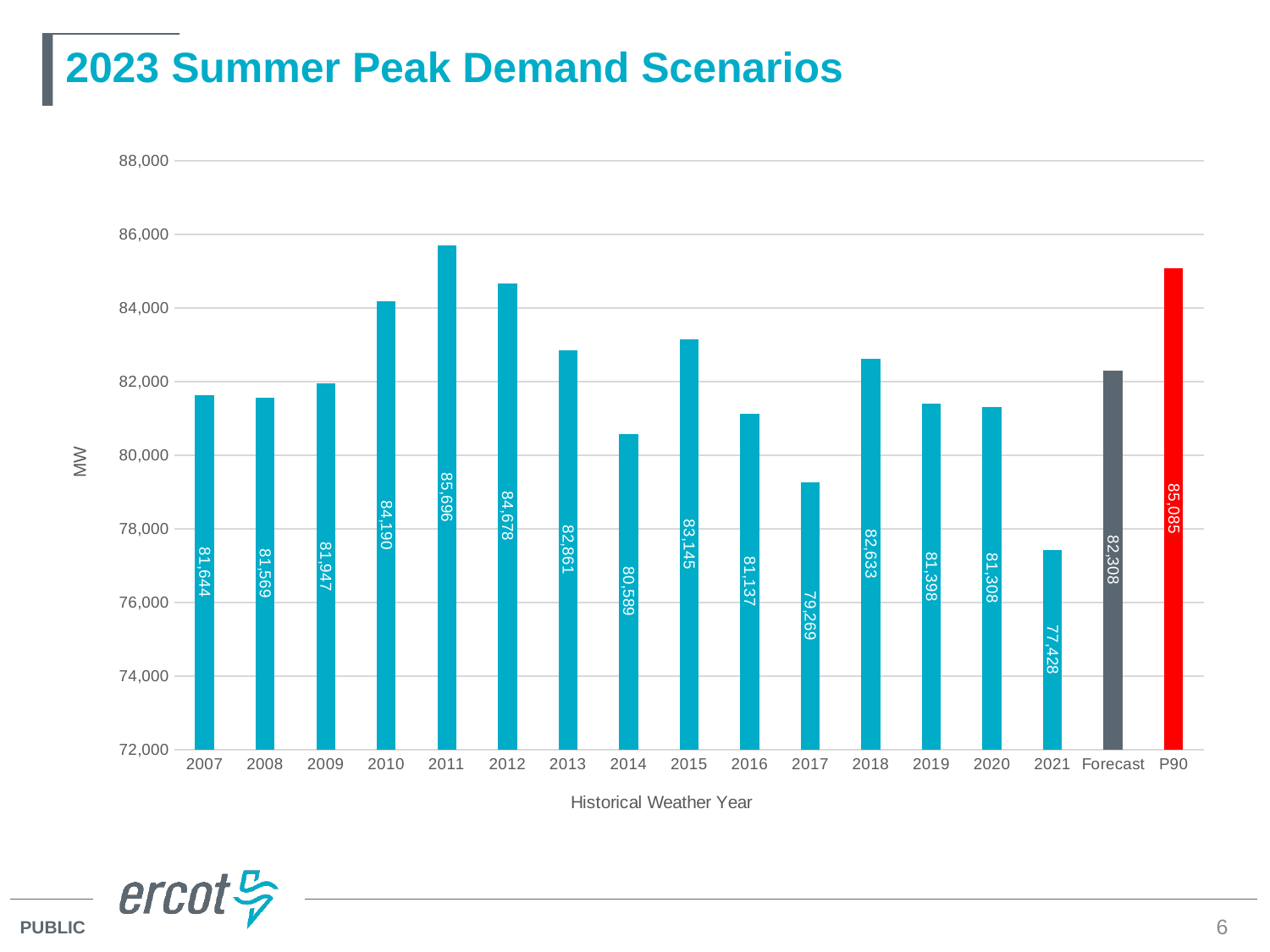
Which category has the highest value? 2011 Which category has the lowest value? 2021 What is the value for 2011? 85,696 What is the value of the Forecast bar? 82,308 What is the difference between the Forecast value and the 2021 value? 4,880 What kind of chart is shown on the slide? Bar chart Which is larger, the value for 2010 or the value for 2012? 2012 What is the label on the vertical axis? MW What is the difference between the 2011 value and the P90 value? 611 How many bars are plotted on the chart? 17 What is the value for P90? 85,085 What is the value for 2017? 79,269